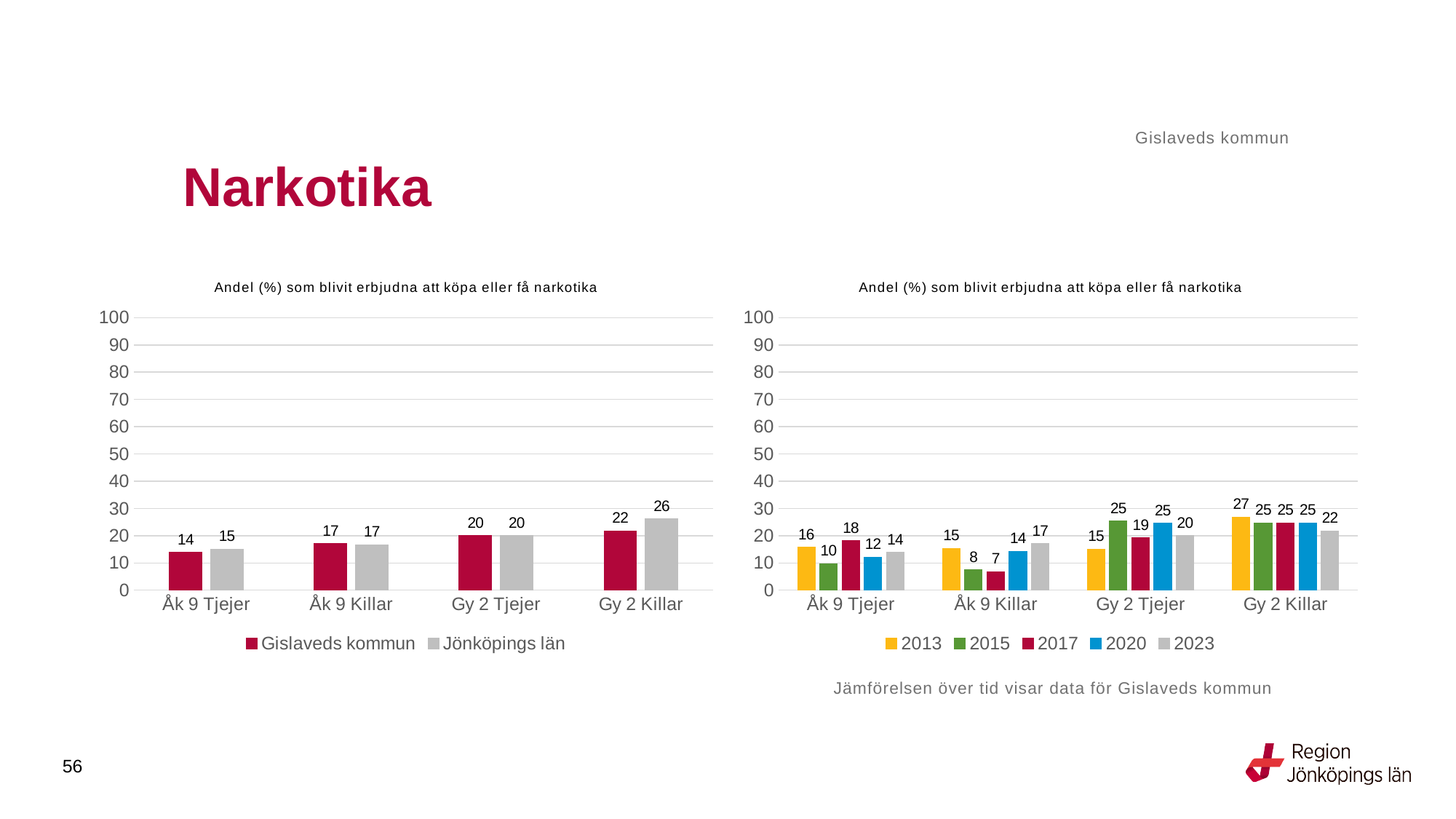
In the right chart, which is larger for Gy 2 Tjejer: the value for 2015 or the value for 2017? 2015 In the right chart, what is the value for 2017 for Åk 9 Killar? 7 In the left chart, what is the difference between Jönköpings län and Gislaveds kommun for Gy 2 Killar? 4 In the right chart, what is the value for 2013 for Gy 2 Killar? 27 In the left chart, which category has the highest value for Jönköpings län? Gy 2 Killar In the left chart, how many series does the legend list? 2 In the left chart, what is the value for Gislaveds kommun for Gy 2 Killar? 22 In the right chart, what is the difference between the 2023 and 2013 values for Åk 9 Killar? 2 What kind of chart is the left chart? Bar chart In the left chart, what is the value for Jönköpings län for Åk 9 Tjejer? 15 In the right chart, how many series does the legend list? 5 In the right chart, which year has the lowest value for Åk 9 Tjejer? 2015